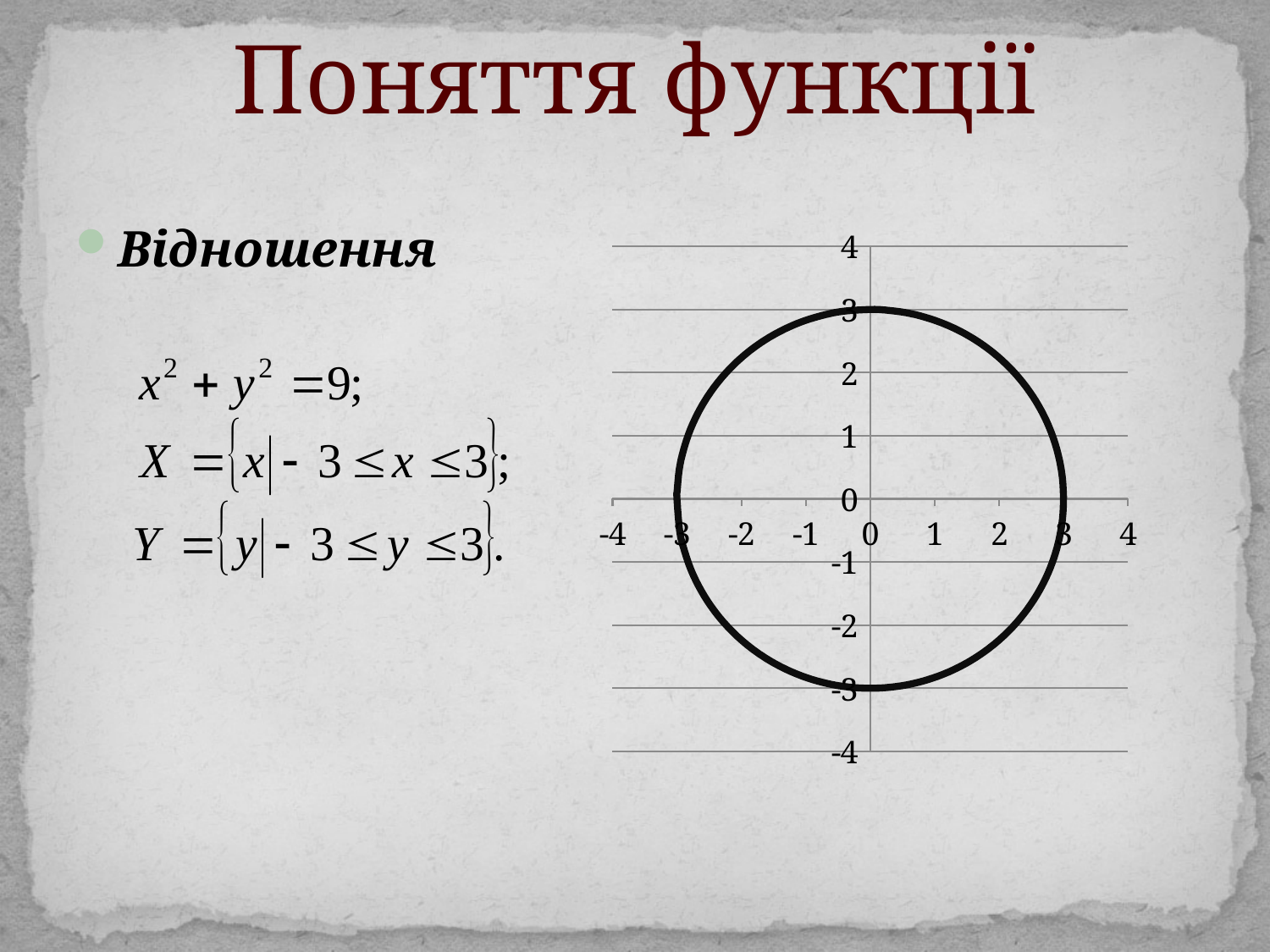
What shape does the curve plotted on the chart form? A circle Is the plotted curve symmetric about the vertical axis? Yes Is the topmost point of the plotted curve greater or less than 2 on the y axis? greater Is the rightmost point of the plotted curve greater or less than 4 on the x axis? less How many tick labels are shown on the vertical axis? 9 What is the smallest x value reached by the plotted curve? -3 What is the highest y value reached by the plotted curve? 3 At what x value does the plotted curve cross the horizontal axis to the left of the origin? -3 What is the largest x value reached by the plotted curve? 3 What is the lowest y value reached by the plotted curve? -3 At what y value does the plotted curve cross the vertical axis above the origin? 3 What is the range of values shown on the horizontal axis? -4 to 4